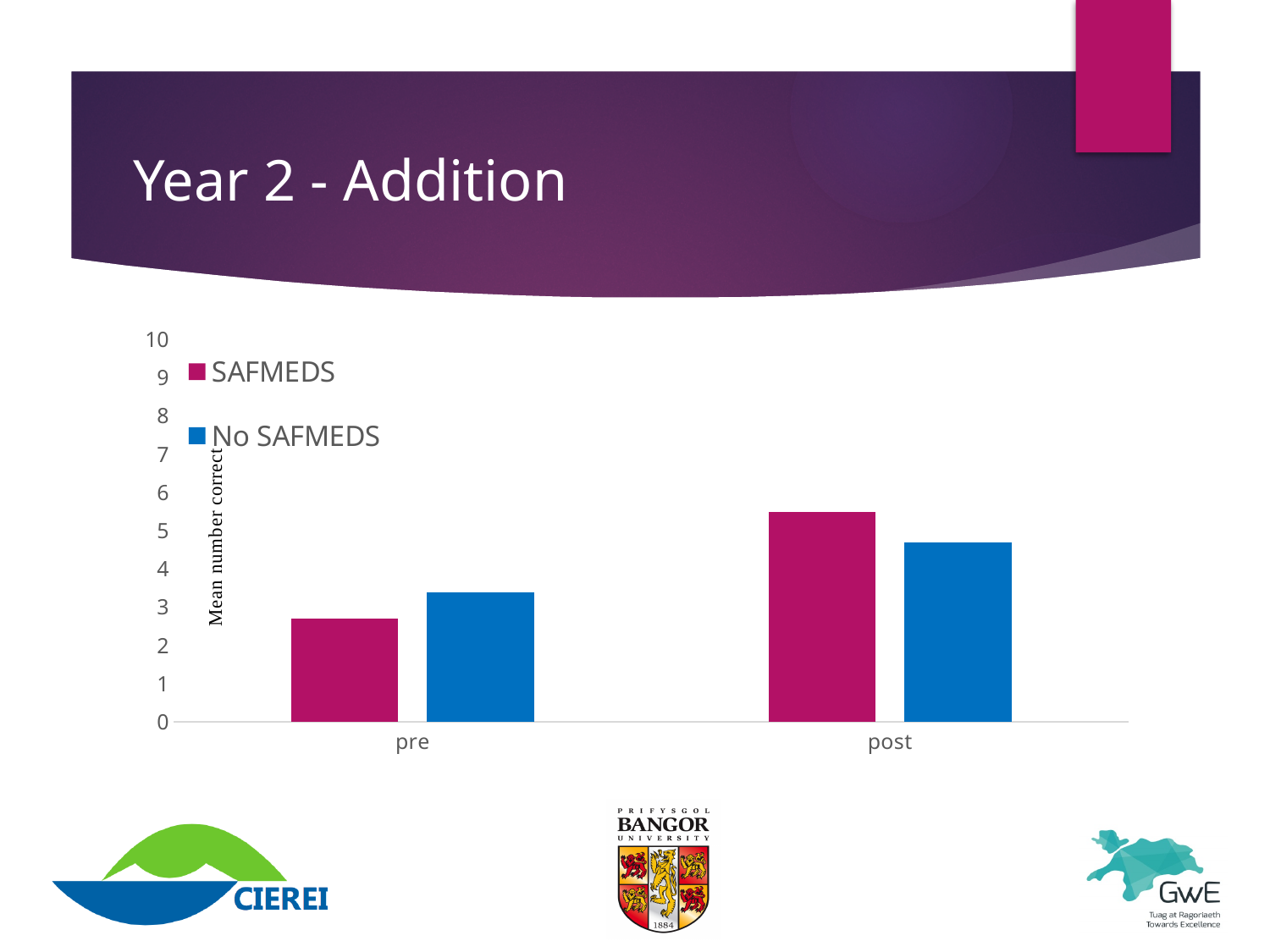
At pre, which series has the larger value, SAFMEDS or No SAFMEDS? No SAFMEDS At post, which series has the larger value, SAFMEDS or No SAFMEDS? SAFMEDS What kind of chart is shown on the slide? bar chart Is the value for SAFMEDS at pre greater or less than 3? less Is the value for No SAFMEDS at post greater or less than 4? greater Is the value for No SAFMEDS at post greater or less than 5? less How many series does the legend list? 2 Does the SAFMEDS series rise or fall from pre to post? rise Which series is shown in blue in the legend? No SAFMEDS What is the label of the vertical axis? Mean number correct How many categories are shown on the x axis? 2